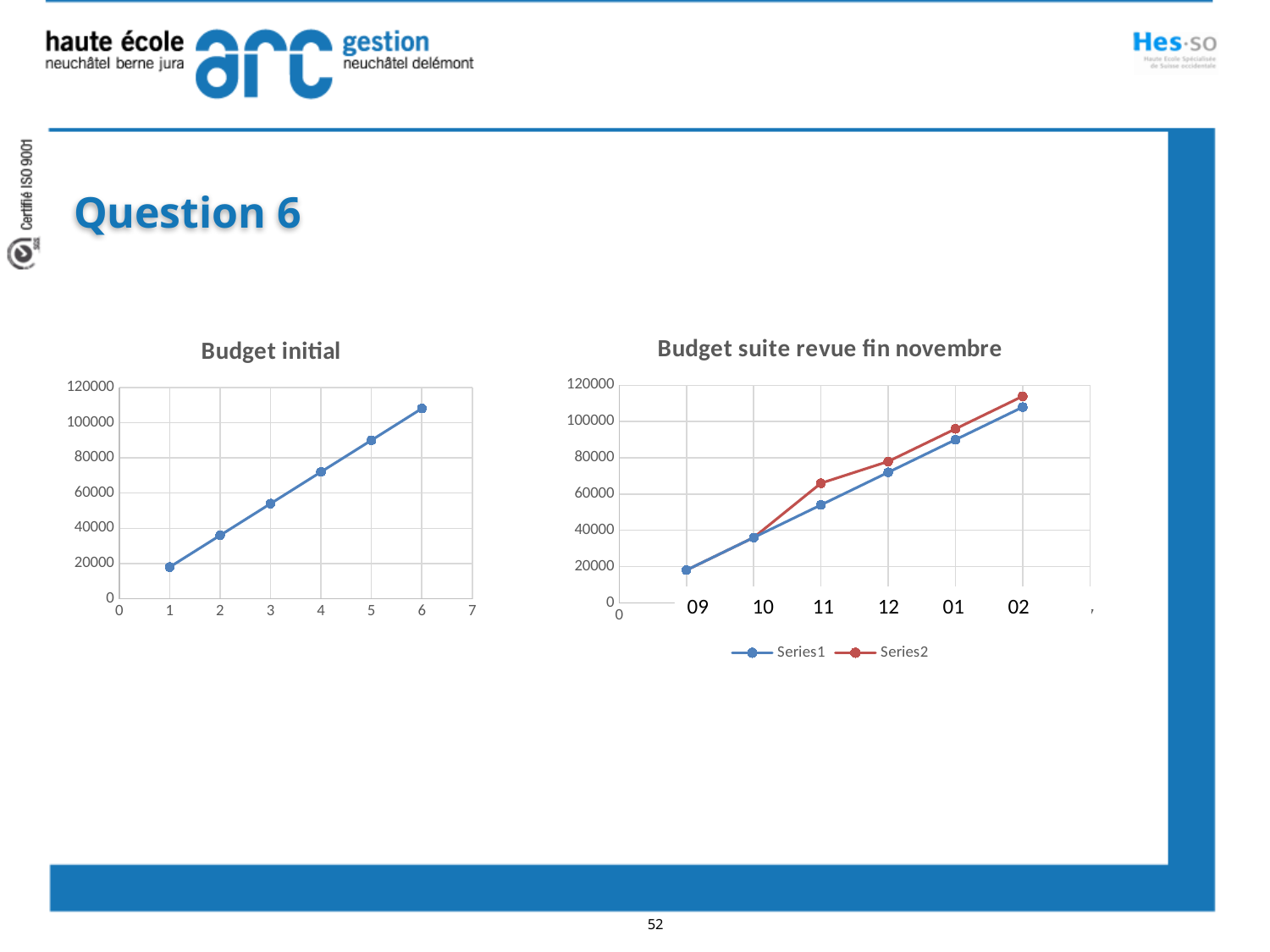
In the "Budget initial" chart, is the value at x = 6 greater or less than 100000? greater In the "Budget suite revue fin novembre" chart, at which x-axis label does Series2 reach its highest value? 02 How many data points are plotted in the "Budget initial" chart? 6 What is the title of the chart on the right side of the slide? Budget suite revue fin novembre What kind of chart is the "Budget initial" chart? line chart In the "Budget initial" chart, do the values rise or fall along the x axis? rise What are the legend entries in the "Budget suite revue fin novembre" chart? Series1, Series2 In the "Budget suite revue fin novembre" chart, is the Series1 value at 12 greater or less than 80000? less How many series does the legend of the "Budget suite revue fin novembre" chart list? 2 In the "Budget suite revue fin novembre" chart, is the Series2 value at 11 greater or less than 60000? greater In the "Budget suite revue fin novembre" chart, which series has the higher value at 11? Series2